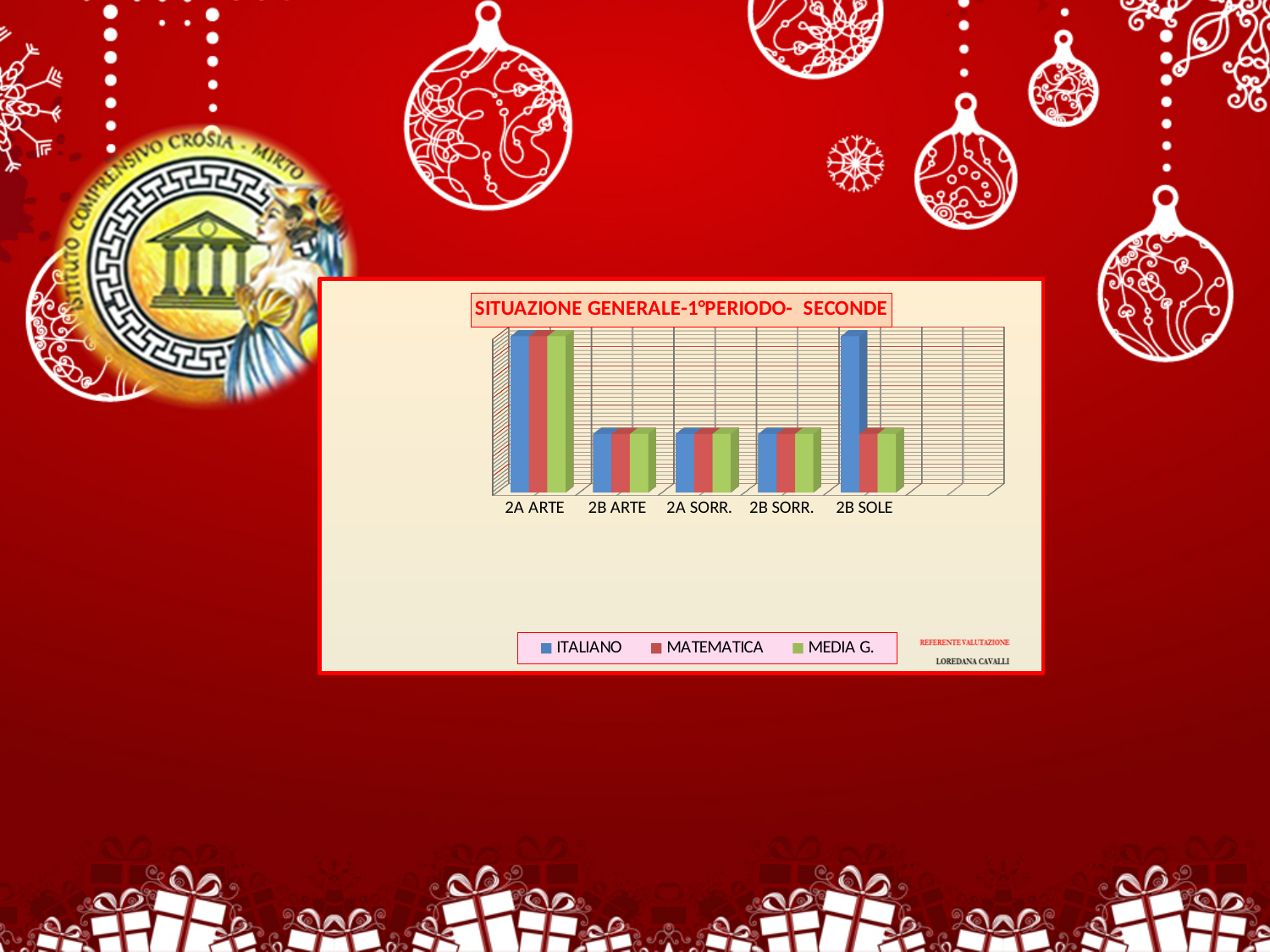
Which category has the highest MEDIA G. value? 2A ARTE For 2B SOLE, which is larger, the ITALIANO value or the MATEMATICA value? ITALIANO Which is larger, the MATEMATICA value for 2A ARTE or the MATEMATICA value for 2A SORR.? 2A ARTE What kind of chart is shown on the slide? bar chart Which is larger, the MEDIA G. value for 2A ARTE or the MEDIA G. value for 2B SOLE? 2A ARTE Which category has the highest MATEMATICA value? 2A ARTE What is the title of the chart? SITUAZIONE GENERALE-1°PERIODO- SECONDE How many series does the chart's legend list? 3 How many categories are shown on the x axis of the chart? 5 Which series is shown in green in the chart? MEDIA G.